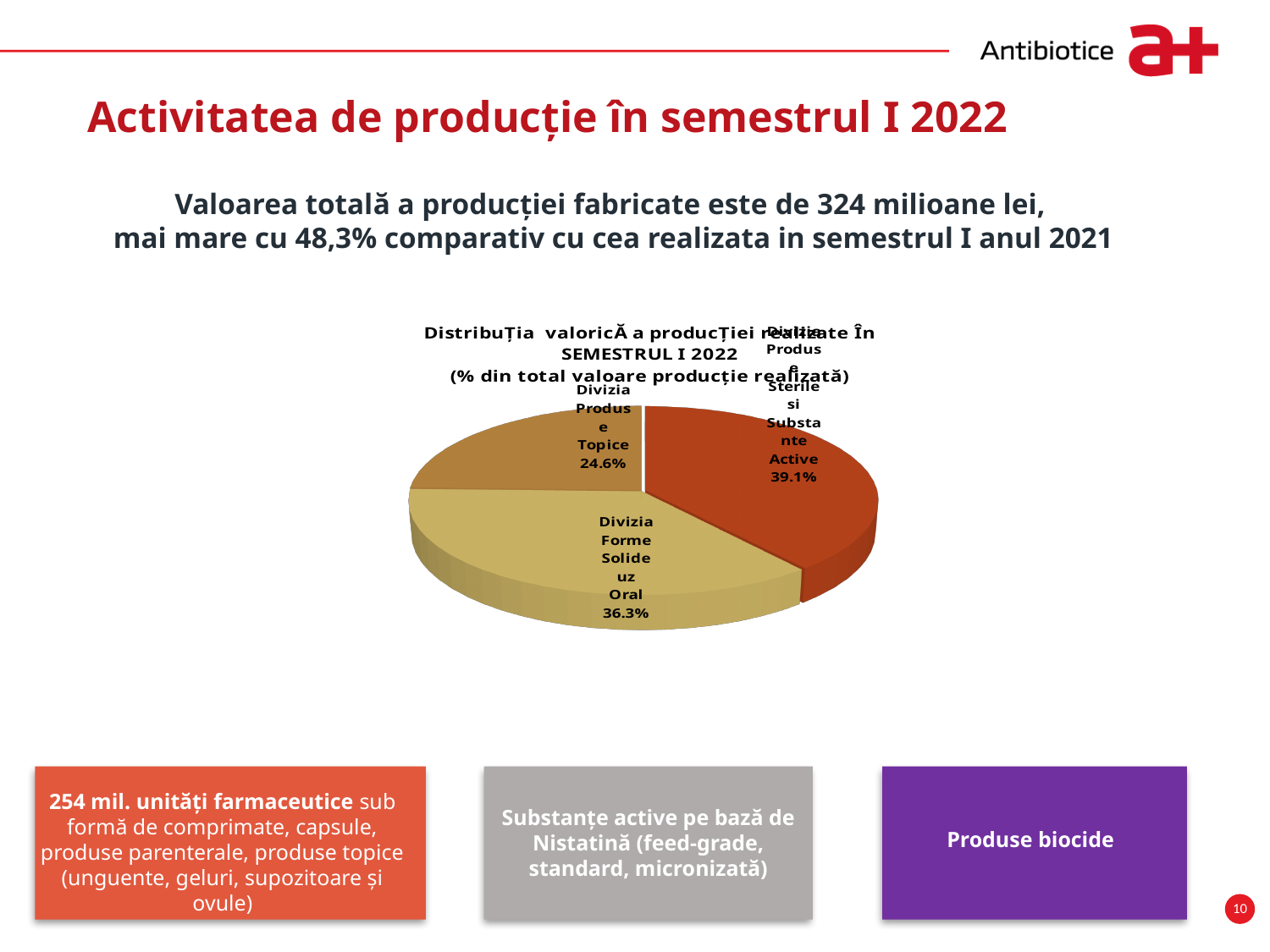
How many slices does the pie chart have? 3 What share of the pie does Divizia Produse Sterile si Substante Active hold? 39.1% What share of the pie does Divizia Produse Topice hold? 24.6% What share of the pie does Divizia Forme Solide uz Oral hold? 36.3% What is the difference in percentage points between Divizia Forme Solide uz Oral and Divizia Produse Topice? 11.7 Which division has the largest share of the pie? Divizia Produse Sterile si Substante Active What type of chart is shown on the slide? pie chart Which is larger: the share of Divizia Forme Solide uz Oral or the share of Divizia Produse Topice? Divizia Forme Solide uz Oral Which division has the smallest share of the pie? Divizia Produse Topice What is the combined share of Divizia Produse Sterile si Substante Active and Divizia Forme Solide uz Oral? 75.4% What is the difference in percentage points between Divizia Produse Sterile si Substante Active and Divizia Forme Solide uz Oral? 2.8 Which period does the pie chart title say the production distribution refers to? SEMESTRUL I 2022